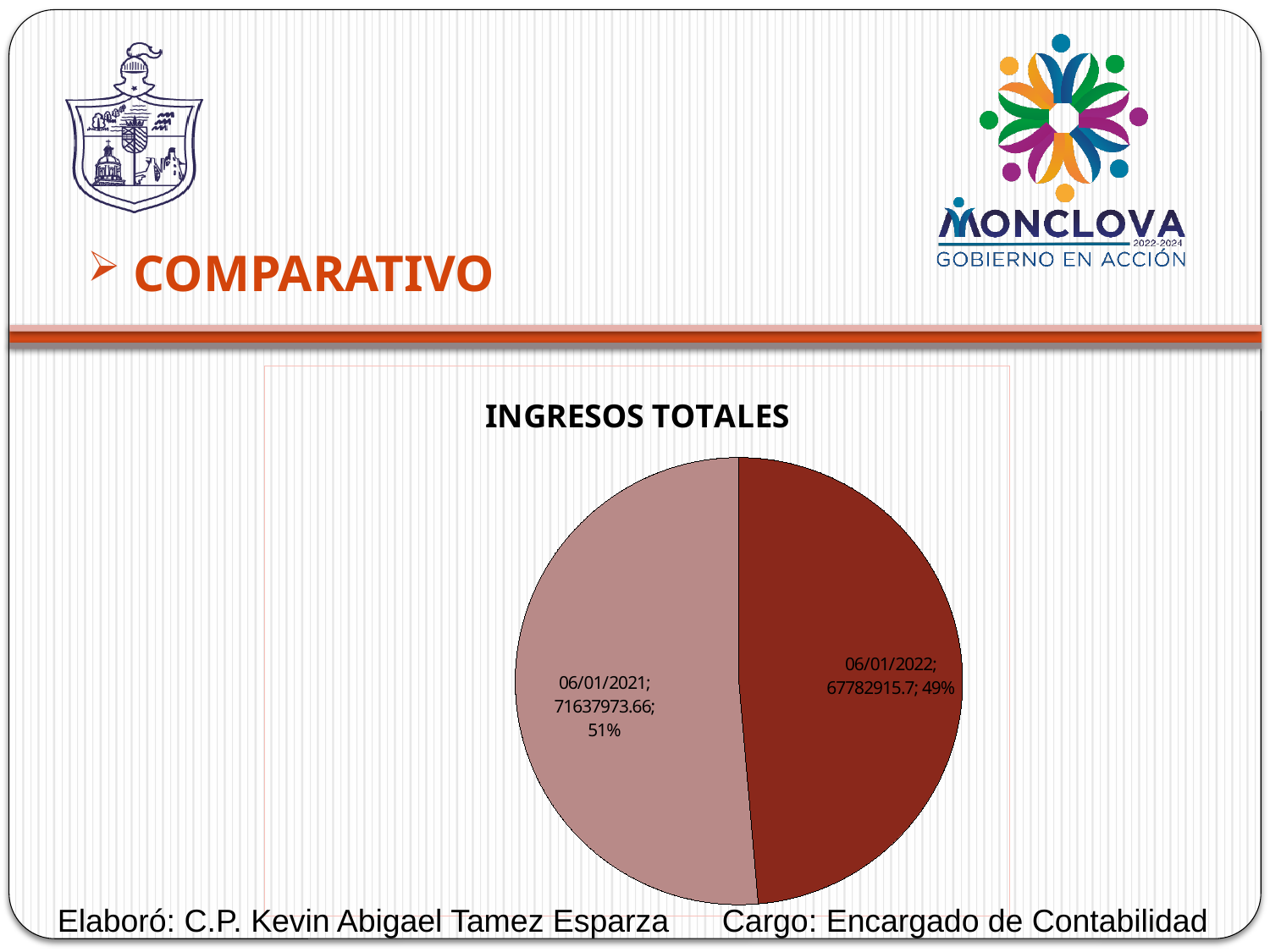
What is the value for 06/01/2022? 67782915.7 What colour is the slice for 06/01/2022? dark red What is the title of the chart? INGRESOS TOTALES Which slice is the smallest? 06/01/2022 How many slices does the pie chart have? 2 What kind of chart is shown on the slide? pie chart What is the difference between the values for 06/01/2021 and 06/01/2022? 3855057.96 What share of the pie does 06/01/2021 represent? 51% What is the value for 06/01/2021? 71637973.66 What share of the pie does 06/01/2022 represent? 49% Which slice is the largest? 06/01/2021 Which is larger, the value for 06/01/2021 or 06/01/2022? 06/01/2021